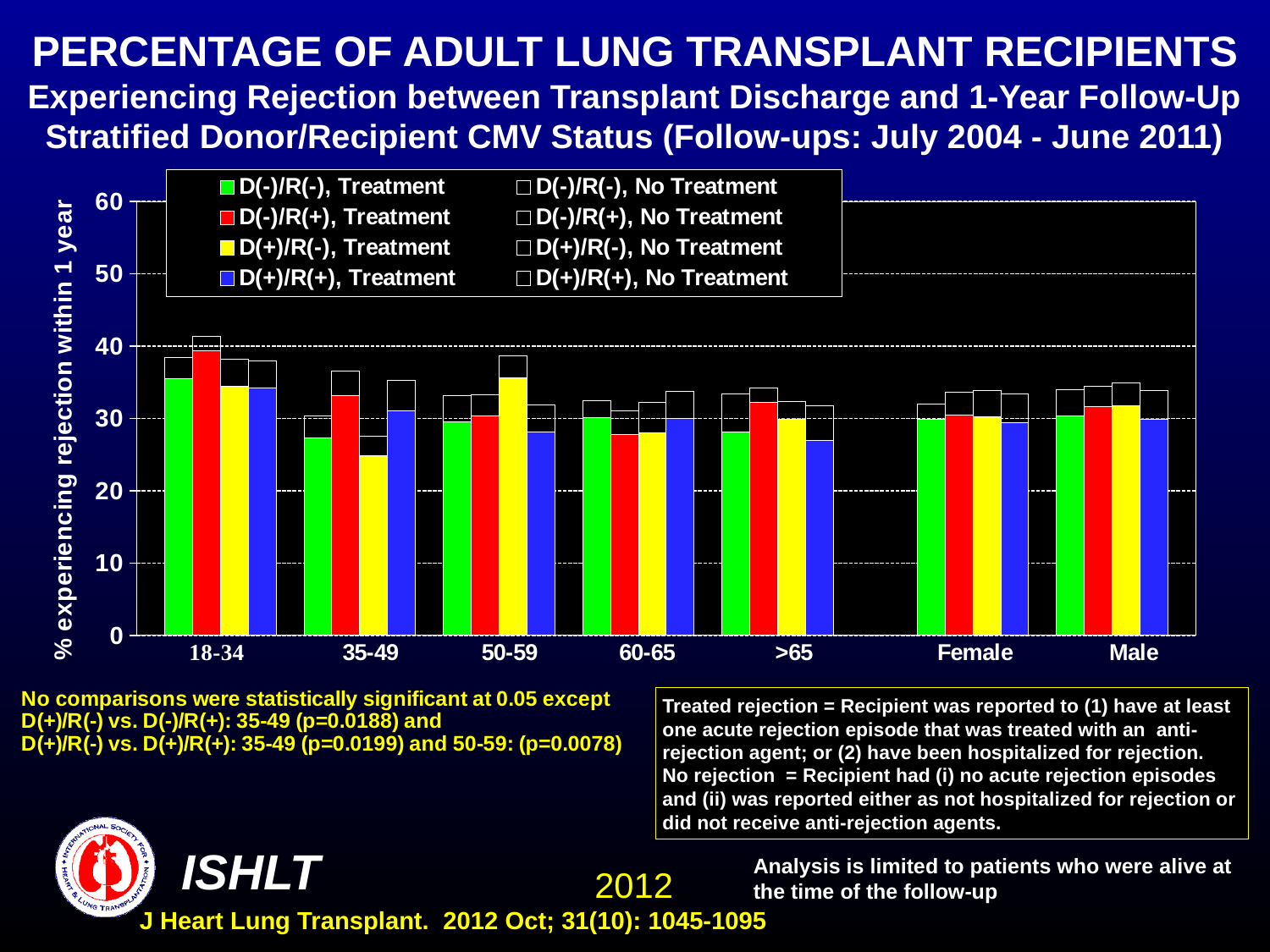
Which is larger: the D(-)/R(-), Treatment value for 18-34 or for 35-49? 18-34 Within the 35-49 age group, which CMV status has the lowest Treatment value? D(+)/R(-) Is the value for D(+)/R(-), Treatment in the 35-49 age group greater or less than 30? less How many series does the legend list? 8 What colour represents D(+)/R(+), Treatment in the legend? blue How many categories are shown along the x axis? 7 Within the 18-34 age group, which CMV status has the highest Treatment value? D(-)/R(+) Is the value for D(+)/R(+), Treatment in the >65 age group greater or less than 30? less Is the value for D(+)/R(-), Treatment in the 50-59 age group greater or less than 30? greater Within the 50-59 age group, which CMV status has the highest Treatment value? D(+)/R(-) What kind of chart is shown on the slide? bar chart